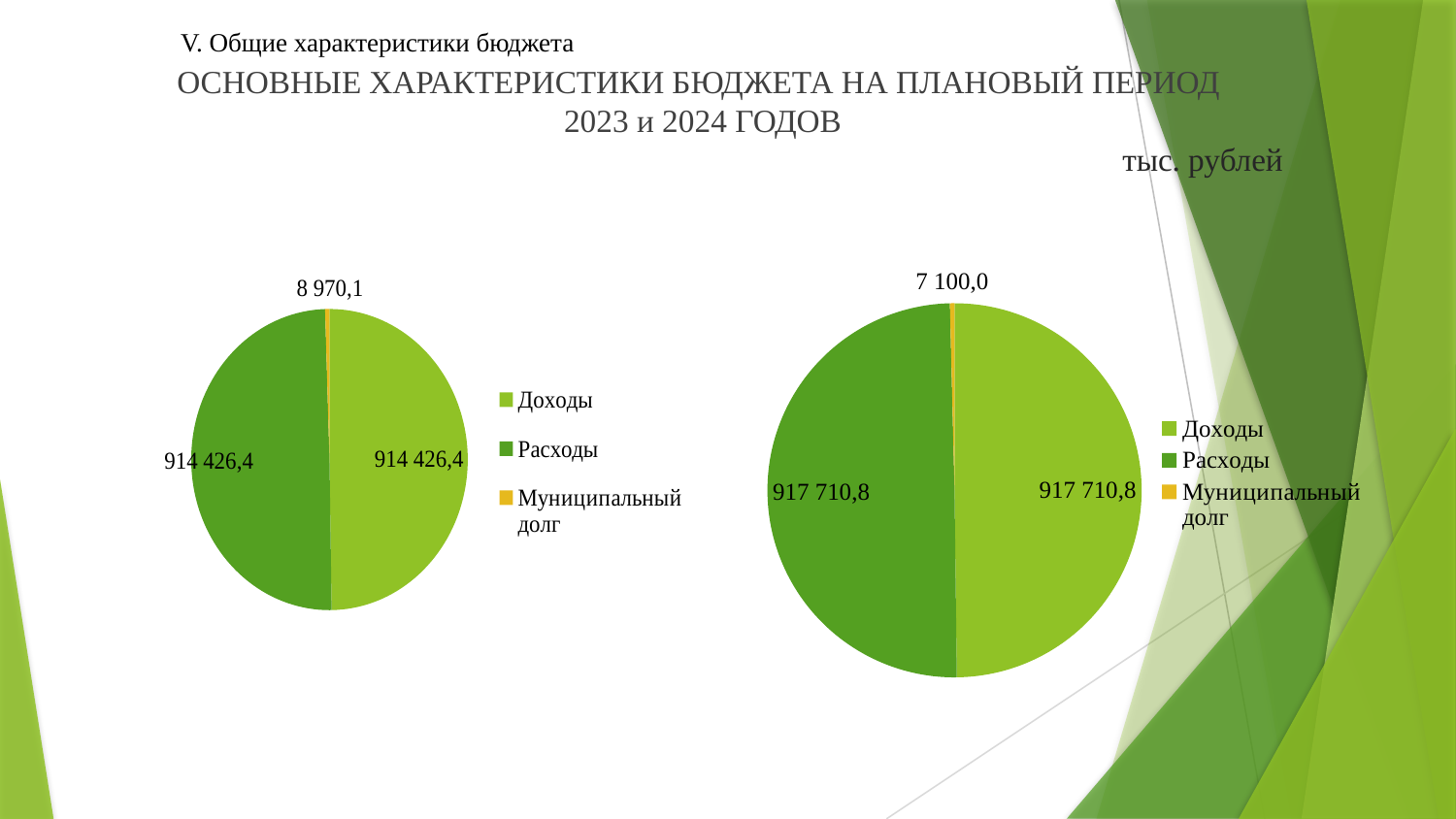
In the right pie chart, which category has the smallest slice? Муниципальный долг What is the difference between Муниципальный долг in the left pie chart and in the right pie chart? 1 870,1 What is the difference between Доходы in the right pie chart and Доходы in the left pie chart? 3 284,4 In the left pie chart, what is the value for Доходы? 914 426,4 What unit of measurement is stated on the slide for the chart values? тыс. рублей In the left pie chart, which category has the smallest slice? Муниципальный долг How many slices does the left pie chart have? 3 What type of chart is shown on the right side of the slide? Pie chart In the right pie chart, what is the value for Расходы? 917 710,8 In the right pie chart, what is the value for Муниципальный долг? 7 100,0 Which is larger: Муниципальный долг in the left pie chart or Муниципальный долг in the right pie chart? Left pie chart (8 970,1) In the left pie chart, what is the value for Муниципальный долг? 8 970,1